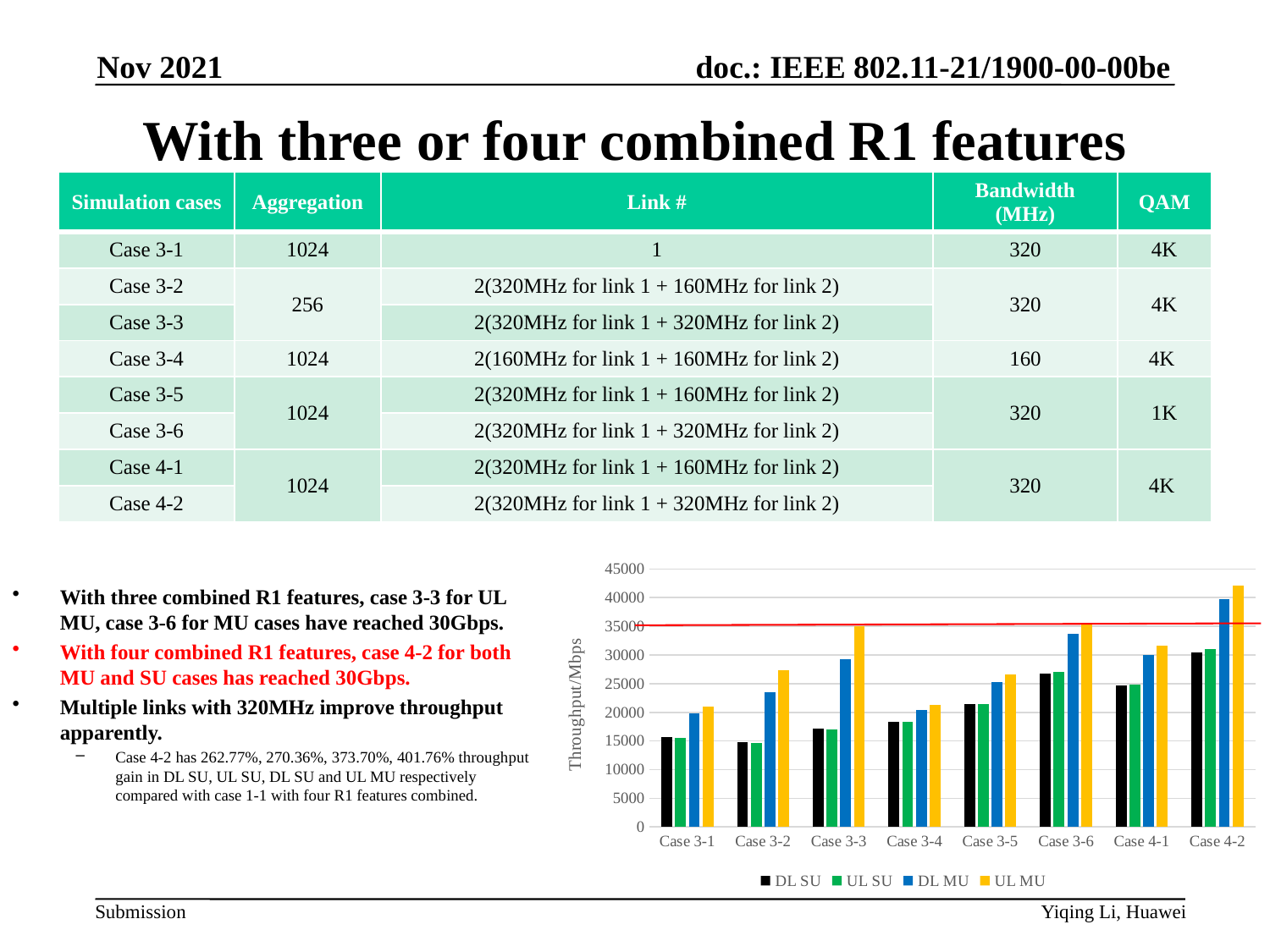
Within Case 3-3, which series has the highest bar? UL MU Which is larger, the DL MU value for Case 3-5 or the DL MU value for Case 3-6? Case 3-6 Is the UL MU value for Case 4-2 greater or less than 40000? greater Is the DL MU value for Case 3-6 greater or less than 30000? greater What is the label of the chart's vertical axis? Throughput/Mbps Which case has the highest UL MU throughput in the chart? Case 4-2 Within Case 4-2, which series has the highest bar? UL MU Is the DL SU value for Case 3-1 greater or less than 20000? less How many series does the chart's legend list? 4 Which series is shown in yellow in the chart's legend? UL MU What kind of chart is shown on the slide? bar chart How many simulation cases are shown on the x axis of the chart? 8